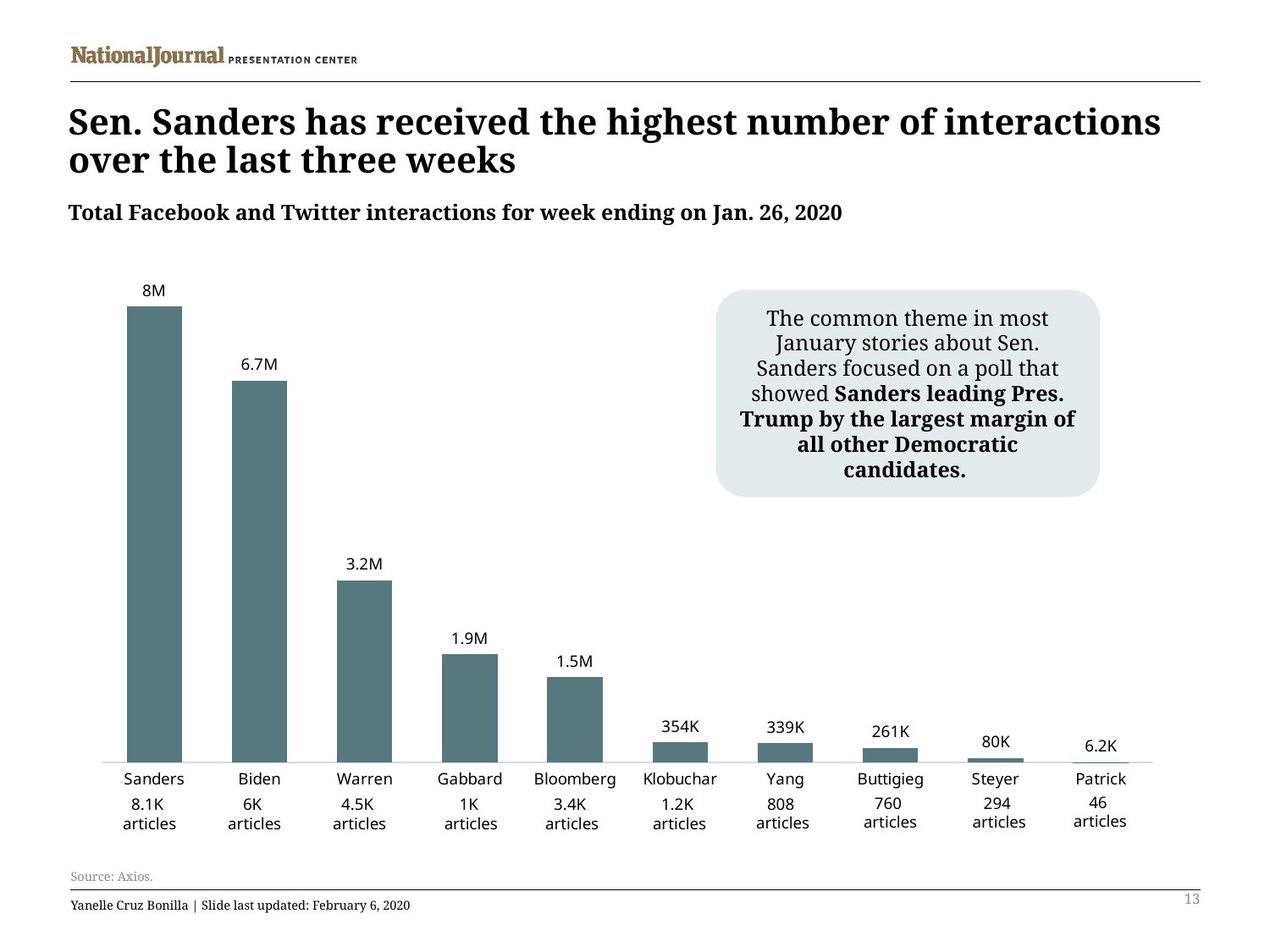
Which candidate has the lowest number of interactions? Patrick What is the value for Patrick? 6.2K What is the value for Sanders? 8M What is the difference between the values for Sanders and Biden? 1.3M What is the difference between the values for Gabbard and Bloomberg? 0.4M How many candidates are shown in the chart? 10 Which candidate has the highest number of interactions? Sanders Do the values rise or fall from left to right along the x axis? Fall What kind of chart is shown on the slide? Bar chart What is the value for Klobuchar? 354K What is the value for Warren? 3.2M Which is larger, the value for Yang or the value for Buttigieg? Yang